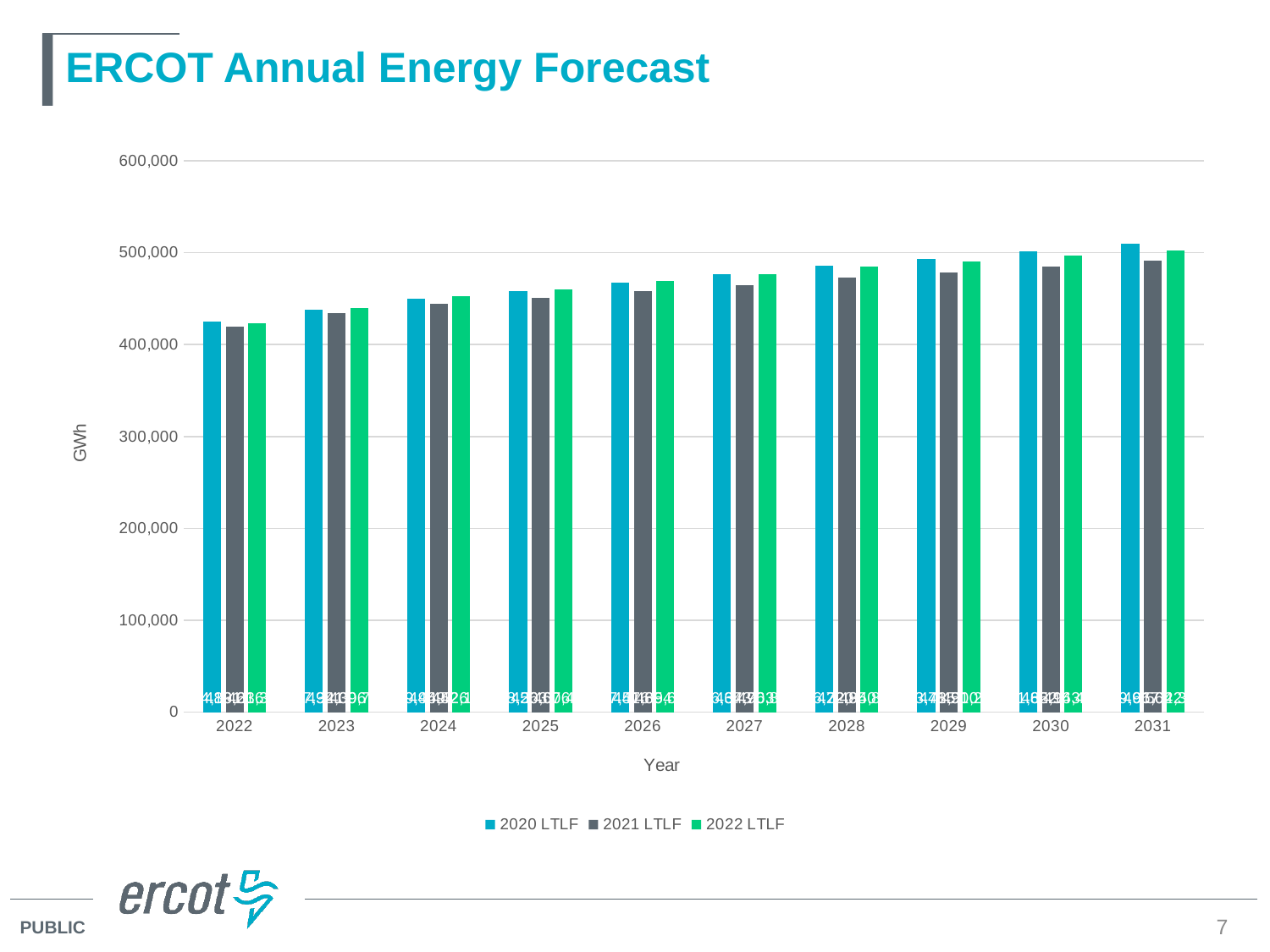
In 2028, which is larger: the 2020 LTLF value or the 2021 LTLF value? 2020 LTLF How many series does the legend list? 3 What is the label of the y axis? GWh Do the 2022 LTLF values rise or fall from 2022 to 2031? rise Which year has the highest 2020 LTLF value? 2031 Which year has the lowest 2021 LTLF value? 2022 Is the 2022 LTLF value for 2022 greater or less than 400,000? greater Is the 2021 LTLF value for 2022 greater or less than 500,000? less How many years are shown on the x axis? 10 What kind of chart is shown on the slide? bar chart Is the 2020 LTLF value for 2031 greater or less than 500,000? greater What is the title of the chart? ERCOT Annual Energy Forecast